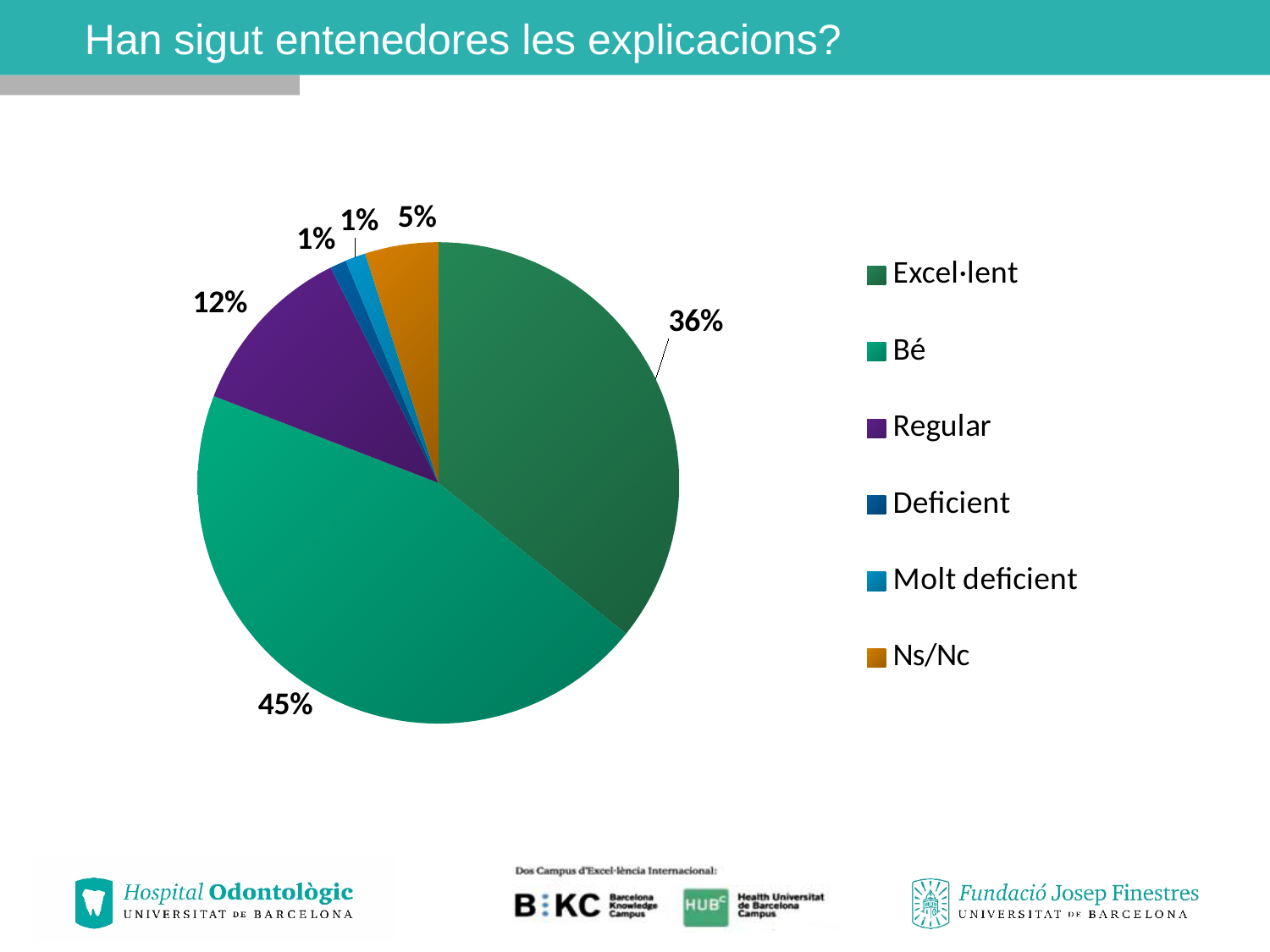
What share of the pie does Bé have? 45% What share of the pie does Deficient have? 1% What share of the pie does Excel·lent have? 36% What is the difference in percentage points between Bé and Excel·lent? 9 How many categories does the legend list? 6 What is the title of the slide containing the chart? Han sigut entenedores les explicacions? Which category has the largest slice after Bé? Excel·lent What kind of chart is shown on the slide? pie chart Which is larger, the share for Regular or the share for Ns/Nc? Regular Which category has the largest slice of the pie? Bé